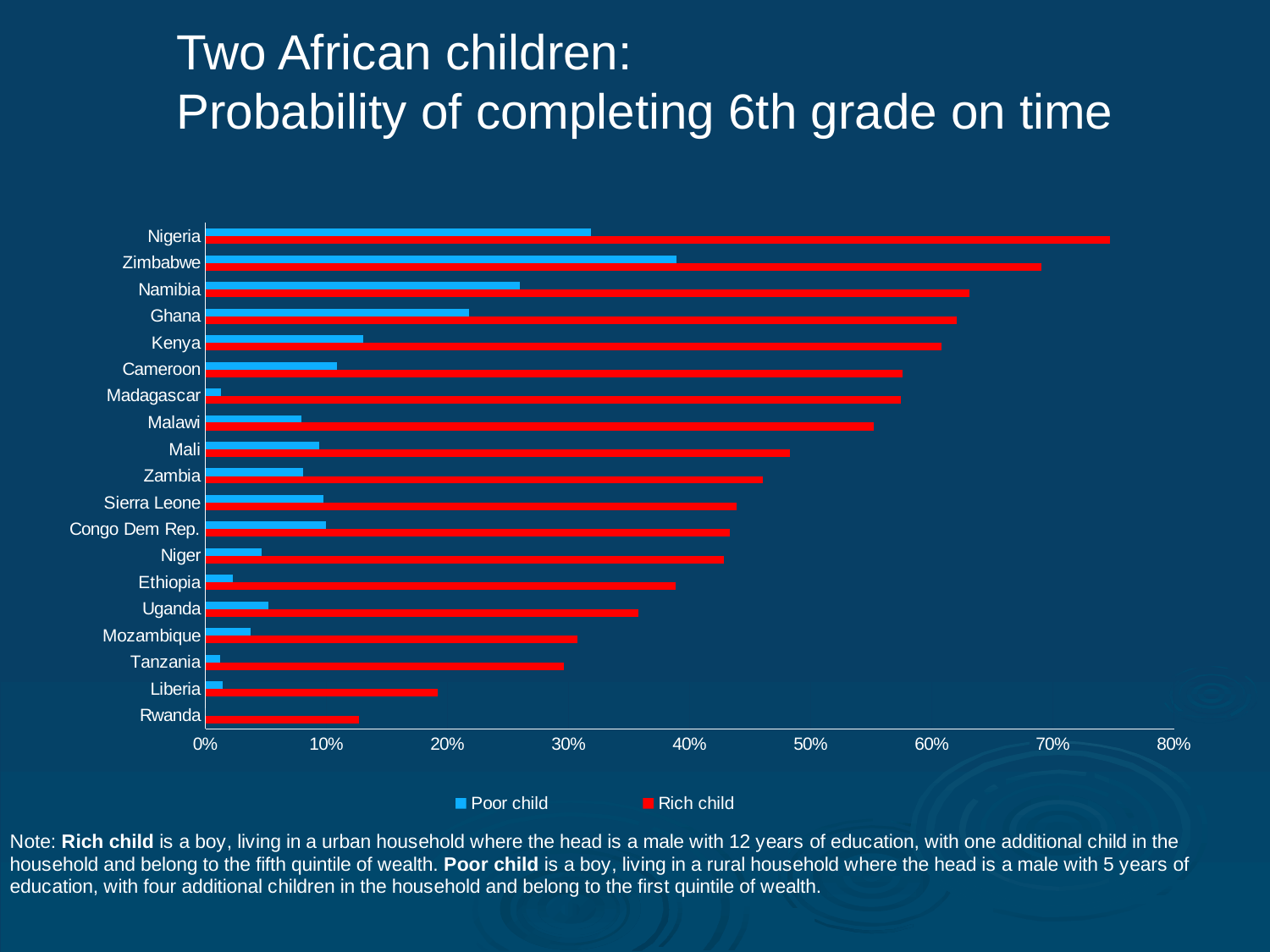
Which colour represents the Poor child series in the legend? Blue Which country has the highest Rich child value? Nigeria Which is larger, the Poor child value for Zimbabwe or the Poor child value for Nigeria? Zimbabwe Is the Poor child value for Ghana greater or less than 20%? greater Is the Rich child value for Nigeria greater or less than 70%? greater Is the Rich child value for Uganda greater or less than 40%? less Which country has the lowest Rich child value? Rwanda What kind of chart is shown on the slide? Bar chart How many countries are plotted on the chart? 19 Which country has the highest Poor child value? Zimbabwe How many series does the legend list? 2 Do the Rich child values rise or fall going down the list from Nigeria to Rwanda? fall